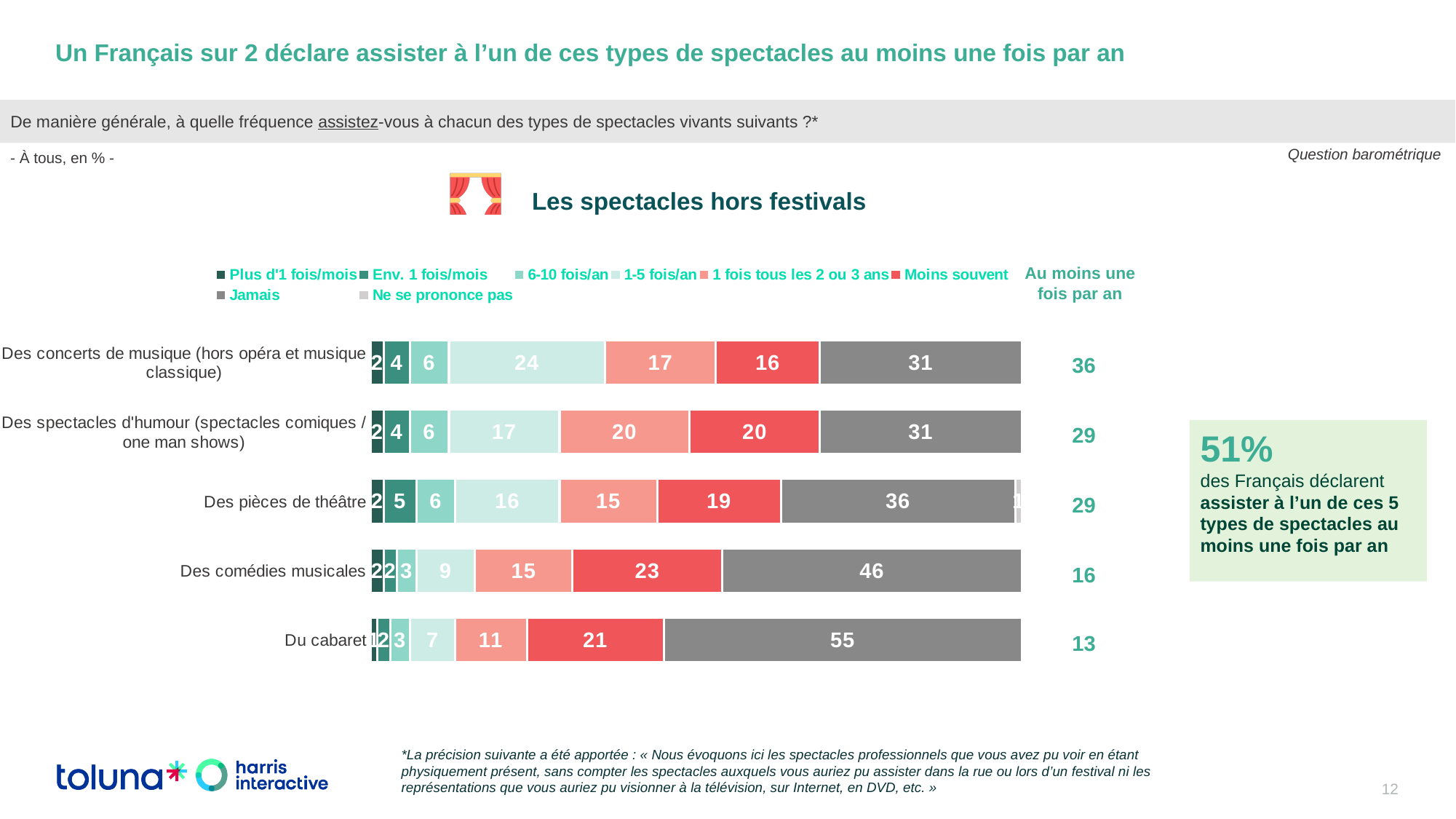
Which category has the highest value for "Jamais"? Du cabaret What is the value for "Moins souvent" for "Des spectacles d'humour (spectacles comiques / one man shows)"? 20 Which category has the highest value for "Moins souvent"? Des comédies musicales Which category has the lowest value for "1-5 fois/an"? Du cabaret What is the difference between the "Jamais" values for "Du cabaret" and "Des concerts de musique (hors opéra et musique classique)"? 24 How many series does the legend list? 8 What is the value for "1-5 fois/an" for "Des concerts de musique (hors opéra et musique classique)"? 24 Which is larger: the "1 fois tous les 2 ou 3 ans" value for "Des spectacles d'humour" or for "Des comédies musicales"? Des spectacles d'humour What is the value for "Jamais" for "Du cabaret"? 55 How many categories (types of spectacles) are shown in the chart? 5 What is the "Au moins une fois par an" value shown for "Des pièces de théâtre"? 29 What kind of chart is shown on the slide? Stacked bar chart